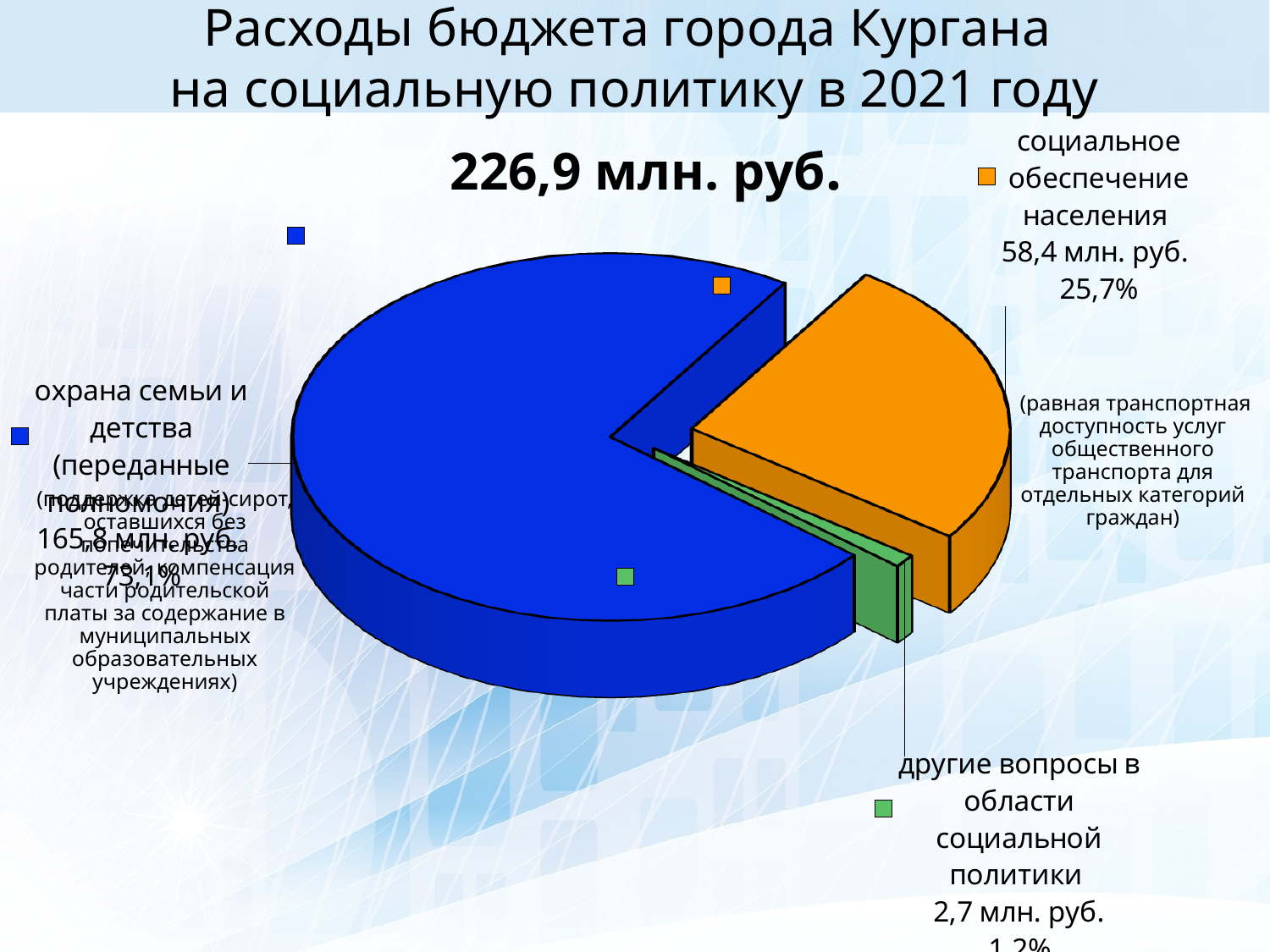
What is the difference between the values for «социальное обеспечение населения» and «другие вопросы в области социальной политики»? 55,7 млн. руб. How many slices does the pie chart have? 3 Which category has the largest slice of the pie? охрана семьи и детства (переданные полномочия) What is the value for «охрана семьи и детства (переданные полномочия)»? 165,8 млн. руб. What share of the pie does «социальное обеспечение населения» take? 25,7% What is the value for «социальное обеспечение населения»? 58,4 млн. руб. What is the value for «другие вопросы в области социальной политики»? 2,7 млн. руб. What is the total amount shown above the pie chart? 226,9 млн. руб. Which category has the smallest slice of the pie? другие вопросы в области социальной политики What kind of chart is shown on the slide? pie chart What share of the pie does «другие вопросы в области социальной политики» take? 1,2% Which is larger: «социальное обеспечение населения» or «другие вопросы в области социальной политики»? социальное обеспечение населения